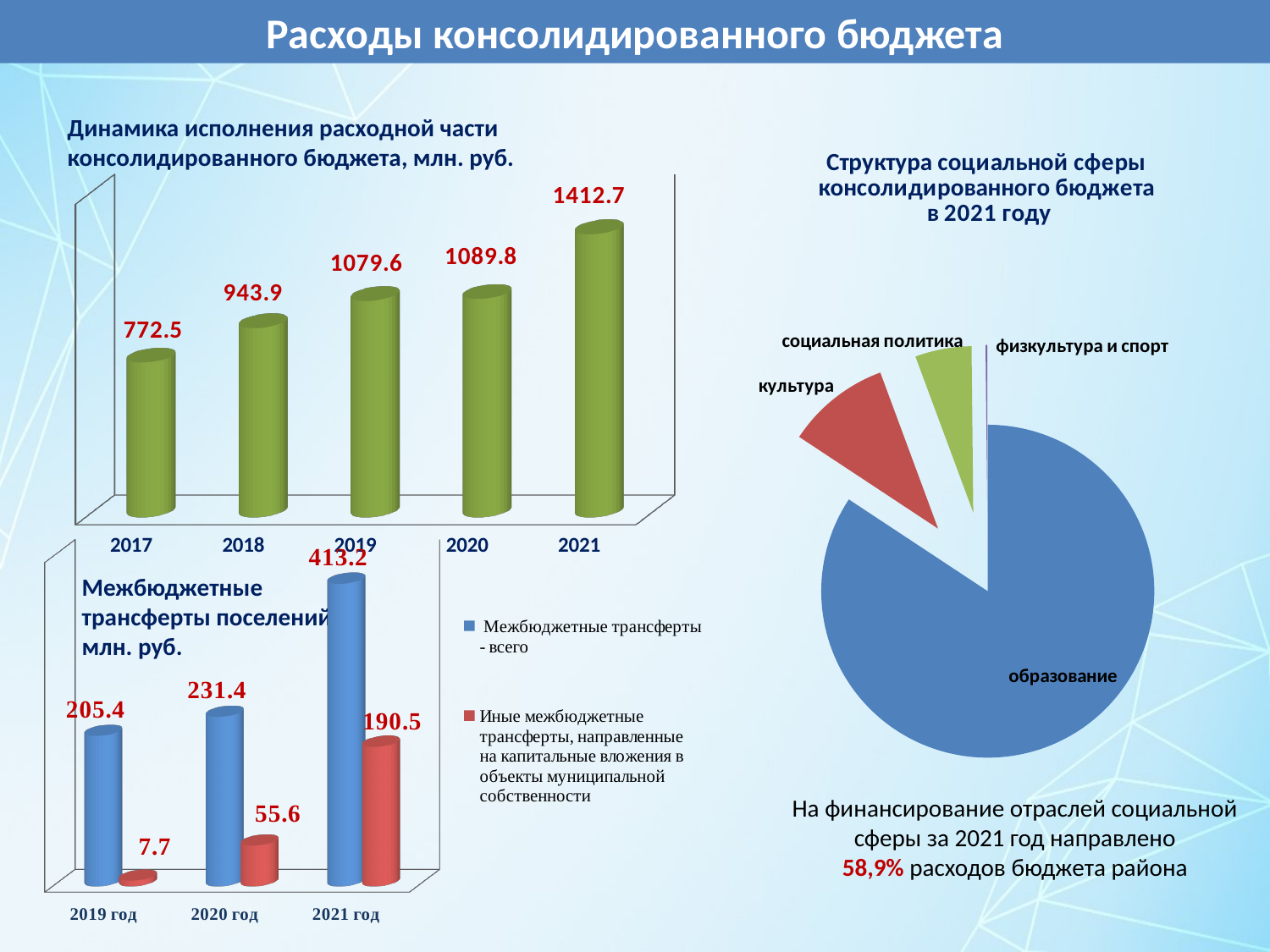
In the chart 'Динамика исполнения расходной части консолидированного бюджета', what is the difference between the 2021 and 2020 values? 322.9 In the chart 'Динамика исполнения расходной части консолидированного бюджета', which year has the lowest value? 2017 In the chart 'Межбюджетные трансферты поселений', what is the value of 'Иные межбюджетные трансферты' for 2019 год? 7.7 How many series does the legend of the chart 'Межбюджетные трансферты поселений' list? 2 What kind of chart is 'Структура социальной сферы консолидированного бюджета в 2021 году'? pie chart How many years are shown in the chart 'Динамика исполнения расходной части консолидированного бюджета'? 5 In the chart 'Динамика исполнения расходной части консолидированного бюджета', what is the value for 2017? 772.5 In the chart 'Динамика исполнения расходной части консолидированного бюджета', do the values rise or fall from 2017 to 2021? rise In the pie chart 'Структура социальной сферы консолидированного бюджета в 2021 году', which slice is the largest? образование In the chart 'Межбюджетные трансферты поселений', what is the difference between the two series in 2021 год? 222.7 In the chart 'Динамика исполнения расходной части консолидированного бюджета', what is the value for 2021? 1412.7 In the chart 'Межбюджетные трансферты поселений', what is the value of 'Межбюджетные трансферты - всего' for 2020 год? 231.4